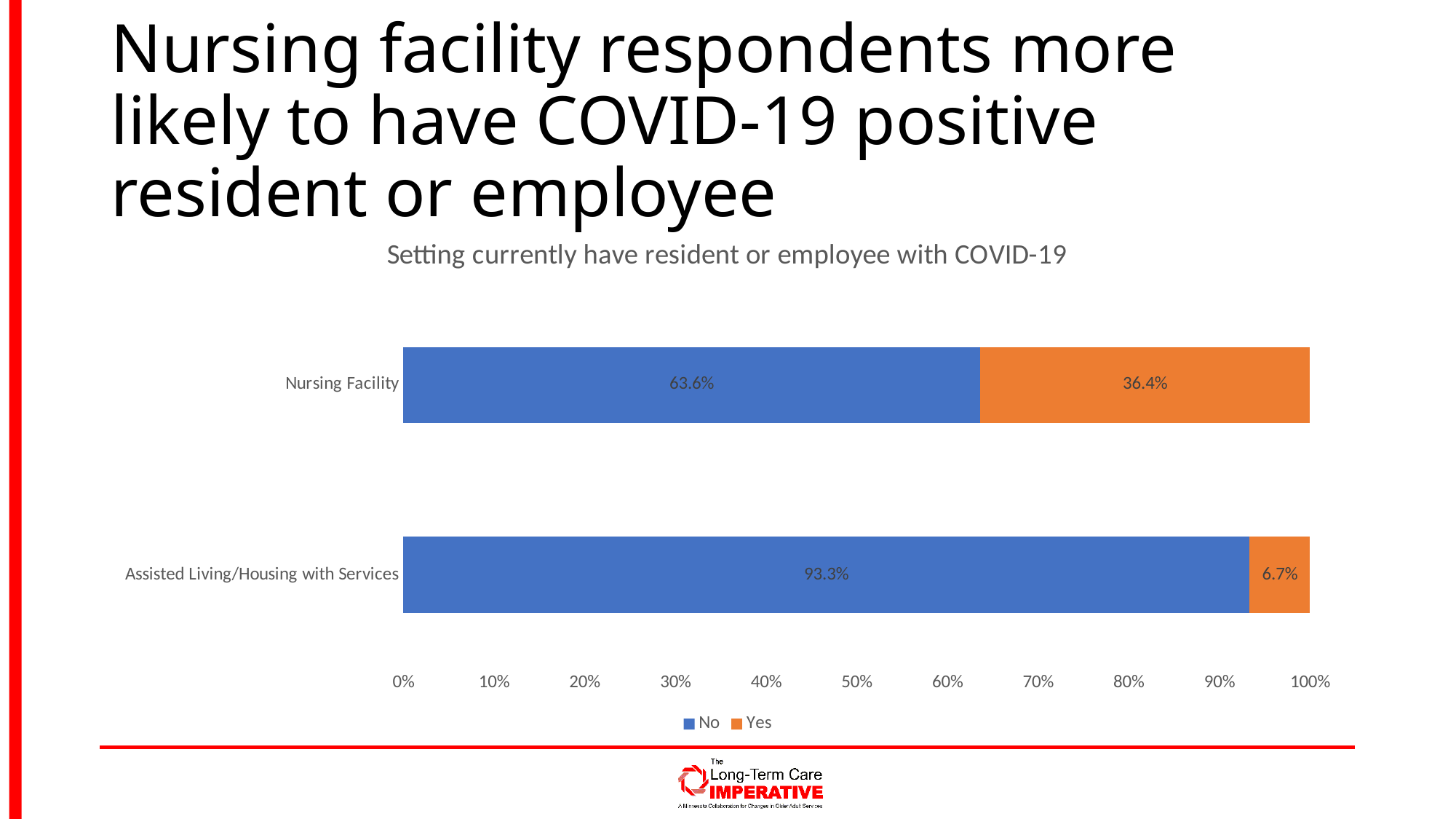
Which setting has the higher "Yes" value? Nursing Facility What is the "No" value for Assisted Living/Housing with Services? 93.3% Which setting has the lower "No" value? Nursing Facility What is the "Yes" value for Nursing Facility? 36.4% What is the difference between the "Yes" values for Nursing Facility and Assisted Living/Housing with Services? 29.7% Is the "No" value for Nursing Facility larger or smaller than the "No" value for Assisted Living/Housing with Services? smaller What is the "Yes" value for Assisted Living/Housing with Services? 6.7% What is the "No" value for Nursing Facility? 63.6% What is the title of the chart? Setting currently have resident or employee with COVID-19 How many settings (categories) are shown in the chart? 2 How many series does the legend list? 2 What kind of chart is shown on the slide? stacked bar chart